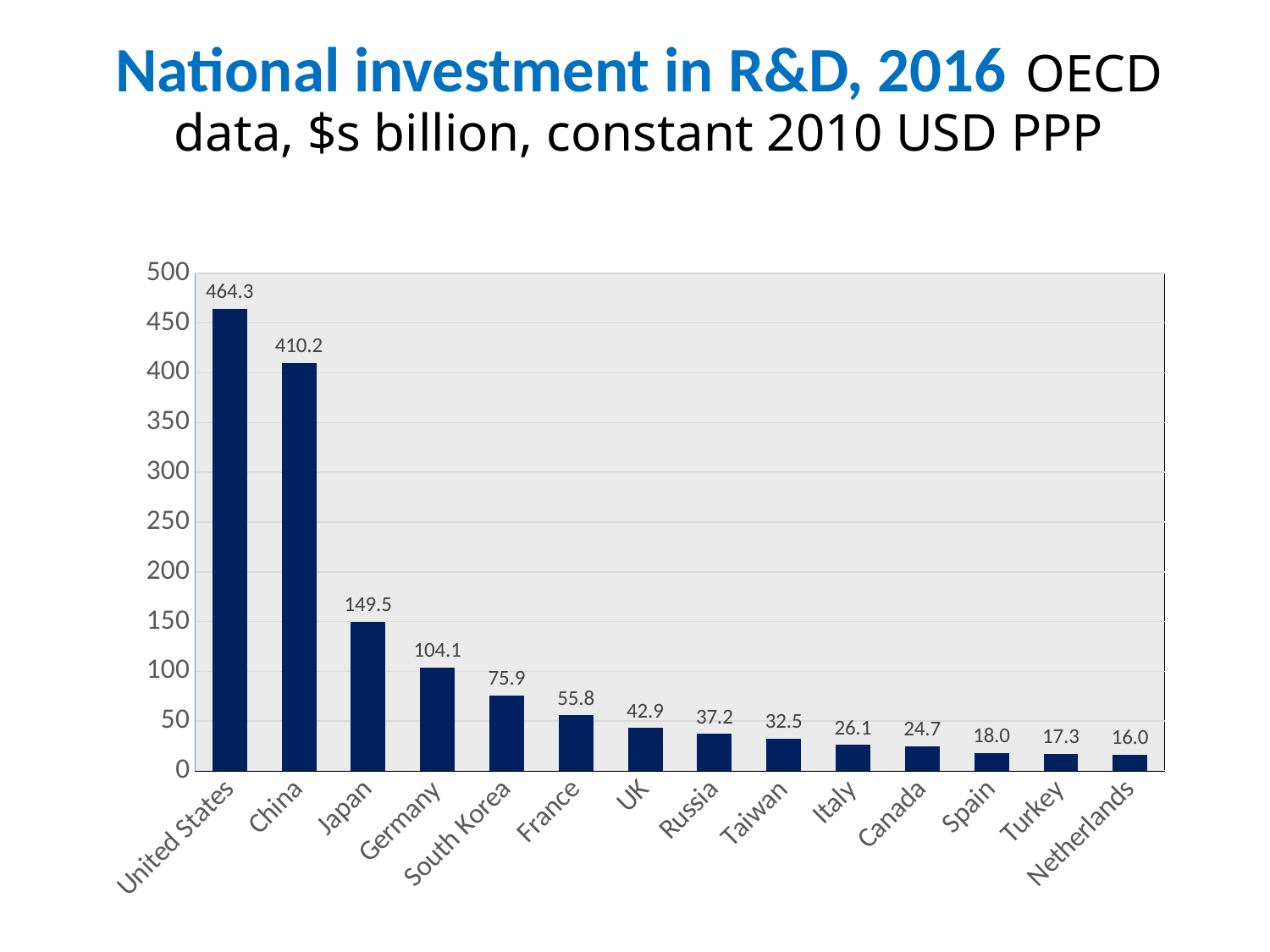
What is the value for the UK? 42.9 Which country has the lowest value? Netherlands What is the value for South Korea? 75.9 Which country has the highest value? United States How many countries are shown in the chart? 14 What is the difference between the values for Germany and France? 48.3 What is the value for Japan? 149.5 What kind of chart is shown on the slide? Bar chart What is the difference between the values for the United States and China? 54.1 Which is larger, the value for Russia or the value for Taiwan? Russia Do the values rise or fall from left to right along the x axis? Fall Is the value for China greater or less than 400? greater